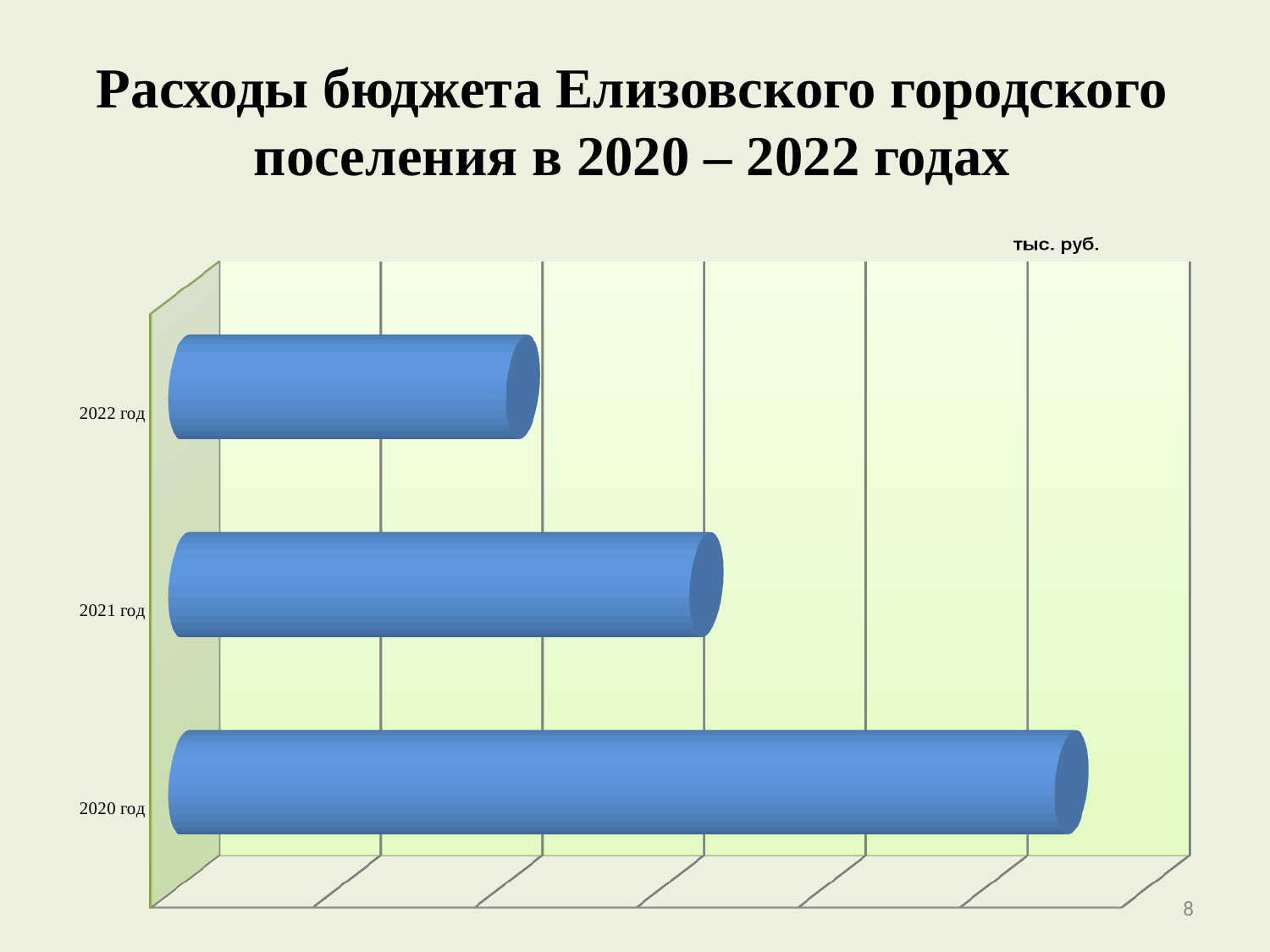
Do the budget expenditures rise or fall from 2020 to 2022? fall Which is larger, the bar for 2021 год or the bar for 2022 год? 2021 год How many categories (years) are plotted in the chart? 3 Which year has the lowest budget expenditure in the chart? 2022 год Which year has the highest budget expenditure in the chart? 2020 год What kind of chart is shown on the slide? bar chart Which is larger, the bar for 2020 год or the bar for 2021 год? 2020 год What is the title of the slide containing the chart? Расходы бюджета Елизовского городского поселения в 2020 – 2022 годах What unit of measurement is indicated on the chart? тыс. руб.